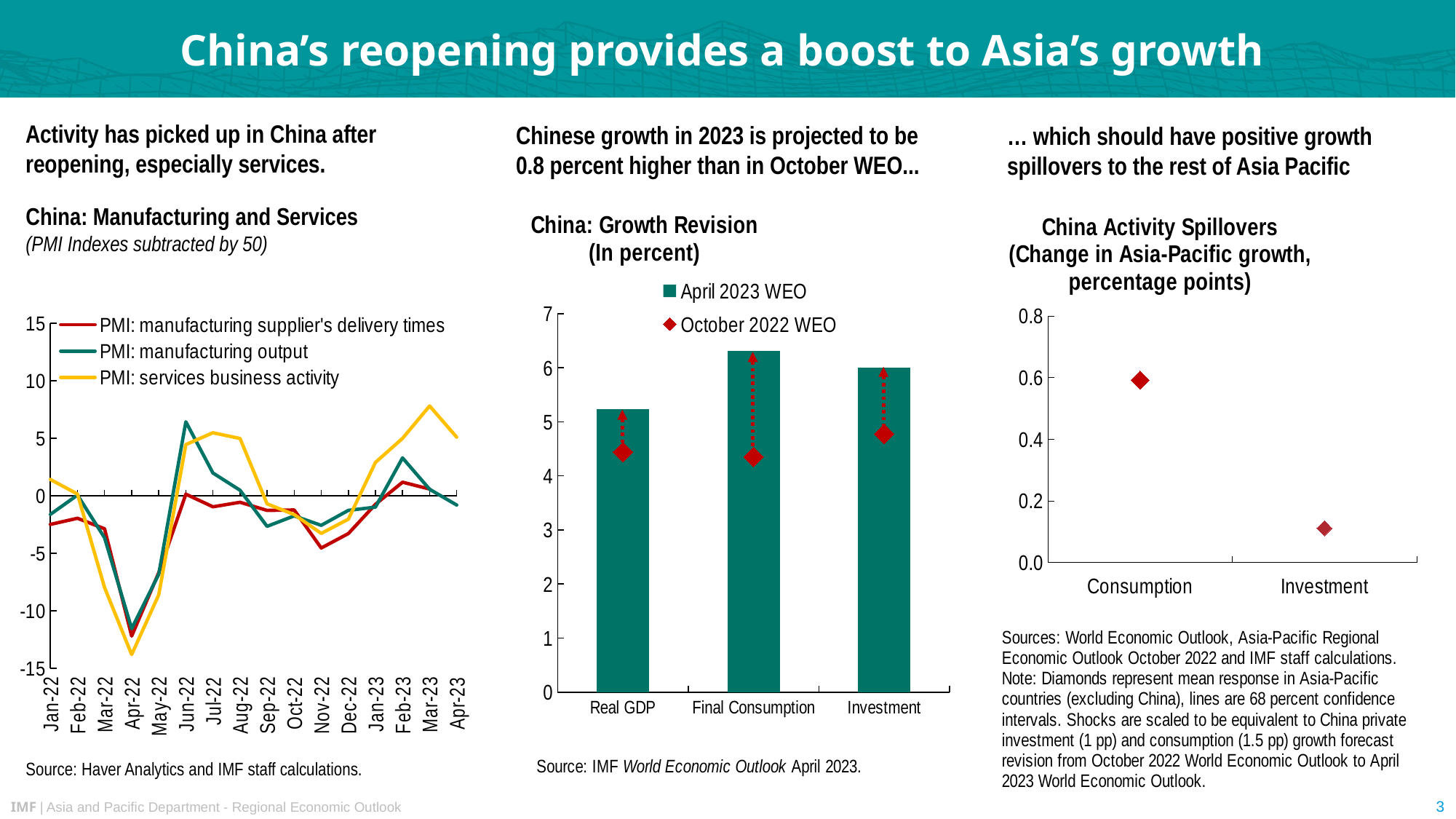
How many categories are shown on the x axis of the 'China: Growth Revision' chart? 3 In the 'China: Growth Revision' chart, which category has the lowest April 2023 WEO value? Real GDP In the 'China Activity Spillovers' chart, which is larger, the value for Consumption or the value for Investment? Consumption What kind of chart is the 'China: Manufacturing and Services' chart? line chart In the 'China: Manufacturing and Services' chart, is the value of PMI: services business activity in Apr-22 greater or less than -10? less In the 'China: Manufacturing and Services' chart, in which month does the PMI: services business activity series reach its lowest value? Apr-22 In the 'China: Growth Revision' chart, is the April 2023 WEO value for Final Consumption greater or less than 6? greater How many months are shown on the x axis of the 'China: Manufacturing and Services' chart? 16 How many series does the legend of the 'China: Manufacturing and Services' chart list? 3 What kind of chart is the 'China: Growth Revision' chart? bar chart In the 'China Activity Spillovers' chart, is the value for Investment greater or less than 0.2? less